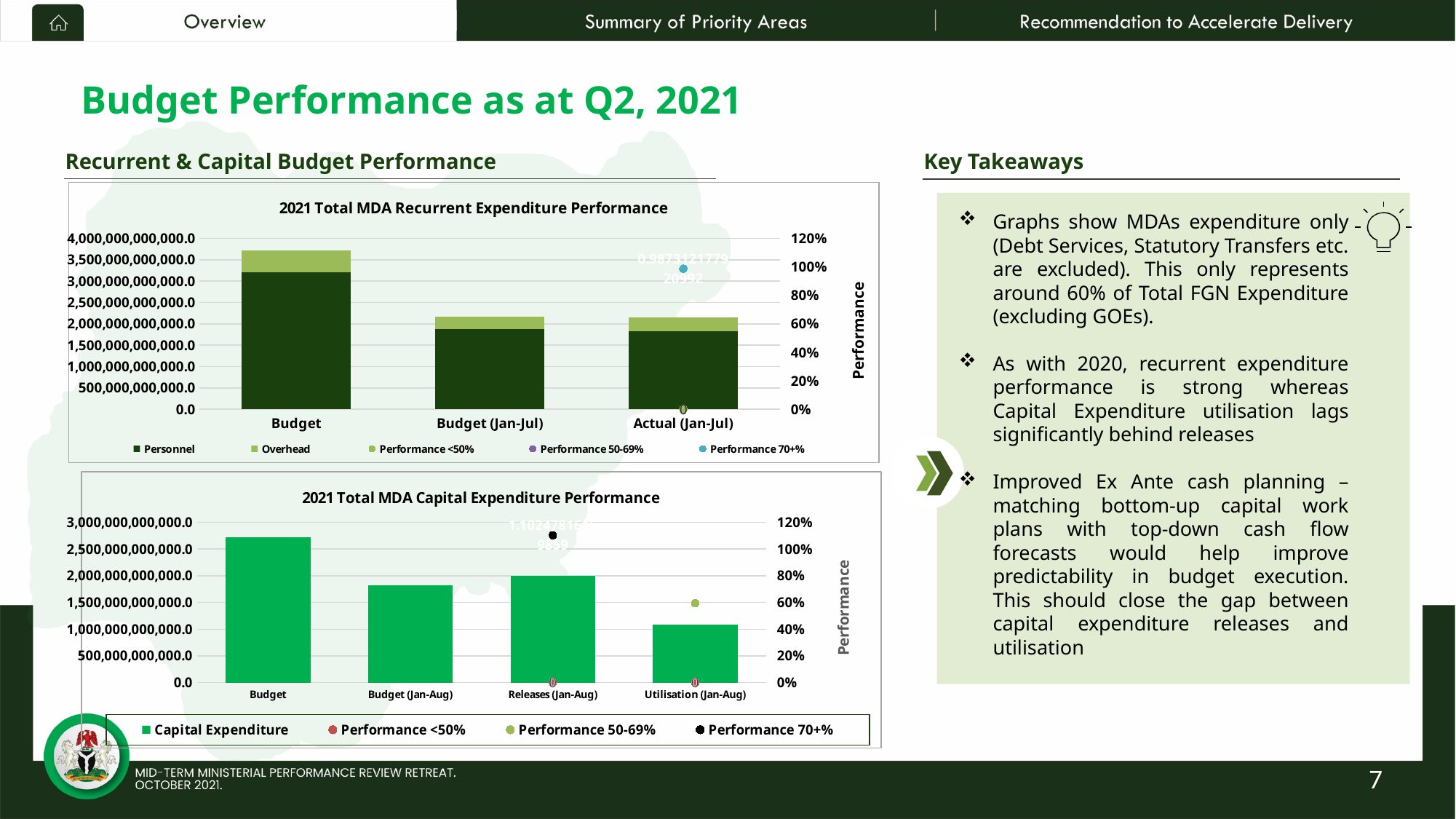
In the '2021 Total MDA Capital Expenditure Performance' chart, which category has the highest Capital Expenditure bar? Budget What kind of chart is the '2021 Total MDA Recurrent Expenditure Performance' chart? bar chart In the '2021 Total MDA Recurrent Expenditure Performance' chart, which category has the tallest stacked bar? Budget In the '2021 Total MDA Recurrent Expenditure Performance' chart, is the total stacked bar for Actual (Jan-Jul) greater or less than 2,500,000,000,000.0? less In the '2021 Total MDA Capital Expenditure Performance' chart, which category has the lowest Capital Expenditure bar? Utilisation (Jan-Aug) In the '2021 Total MDA Capital Expenditure Performance' chart, is the Capital Expenditure value for Utilisation (Jan-Aug) greater or less than 1,500,000,000,000.0? less In the '2021 Total MDA Capital Expenditure Performance' chart, how many entries does the legend list? 4 In the '2021 Total MDA Recurrent Expenditure Performance' chart, is the Personnel value for Budget greater or less than 3,000,000,000,000.0? greater In the '2021 Total MDA Recurrent Expenditure Performance' chart, how many categories are shown on the x axis? 3 In the '2021 Total MDA Capital Expenditure Performance' chart, how many bars are shown? 4 In the '2021 Total MDA Capital Expenditure Performance' chart, which is larger, the Capital Expenditure bar for Budget or for Utilisation (Jan-Aug)? Budget In the '2021 Total MDA Recurrent Expenditure Performance' chart, how many entries does the legend list? 5